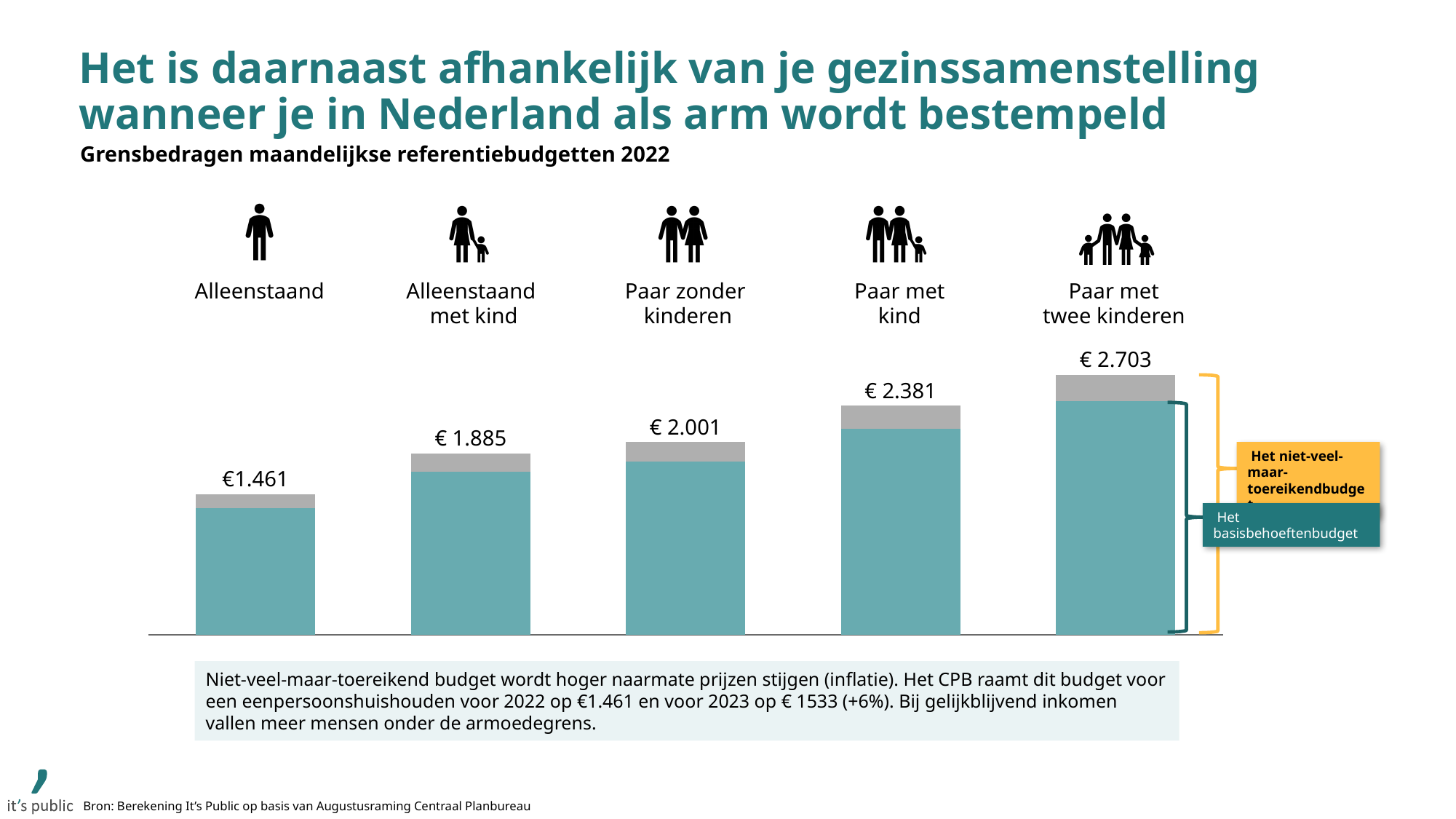
Which household type has the highest total reference budget? Paar met twee kinderen Which has a larger total budget: 'Paar zonder kinderen' or 'Alleenstaand met kind'? Paar zonder kinderen What is the total monthly reference budget shown for 'Paar zonder kinderen'? € 2.001 What is the difference between the total budget for 'Alleenstaand met kind' and 'Alleenstaand'? € 424 What is the total monthly reference budget shown for 'Alleenstaand'? €1.461 What is the total monthly reference budget shown for 'Paar met kind'? € 2.381 What is the difference between the total budget for 'Paar met twee kinderen' and 'Paar met kind'? € 322 Which household type has the lowest total reference budget? Alleenstaand What kind of chart is used on this slide? Stacked bar chart Do the total budgets rise or fall from left to right across the household types? Rise How many household types are shown in the chart? 5